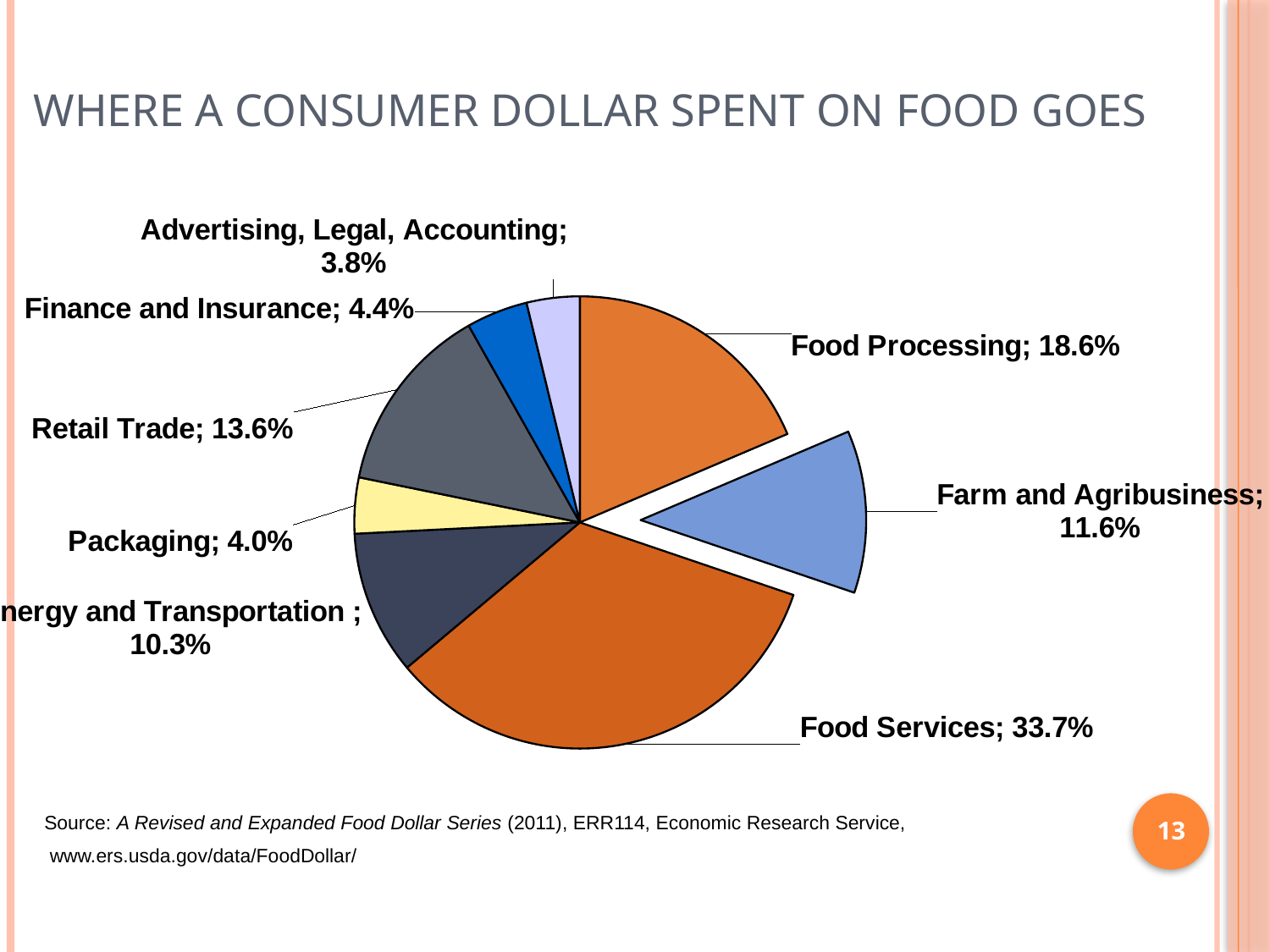
How many slices does the pie chart have? 8 Which slice is pulled out (exploded) from the rest of the pie? Farm and Agribusiness What type of chart is shown on the slide? Pie chart How much larger is the Food Services share than the Food Processing share, in percentage points? 15.1 What share is labelled for Farm and Agribusiness? 11.6% Which category receives the largest share of the consumer food dollar? Food Services What percentage is shown for Retail Trade? 13.6% What is the difference in percentage points between Retail Trade and Farm and Agribusiness? 2.0 What share of the consumer food dollar goes to Food Processing? 18.6% Which is larger, the share for Packaging or the share for Finance and Insurance? Finance and Insurance What percentage is shown for Finance and Insurance? 4.4% Which category has the smallest slice of the pie? Advertising, Legal, Accounting